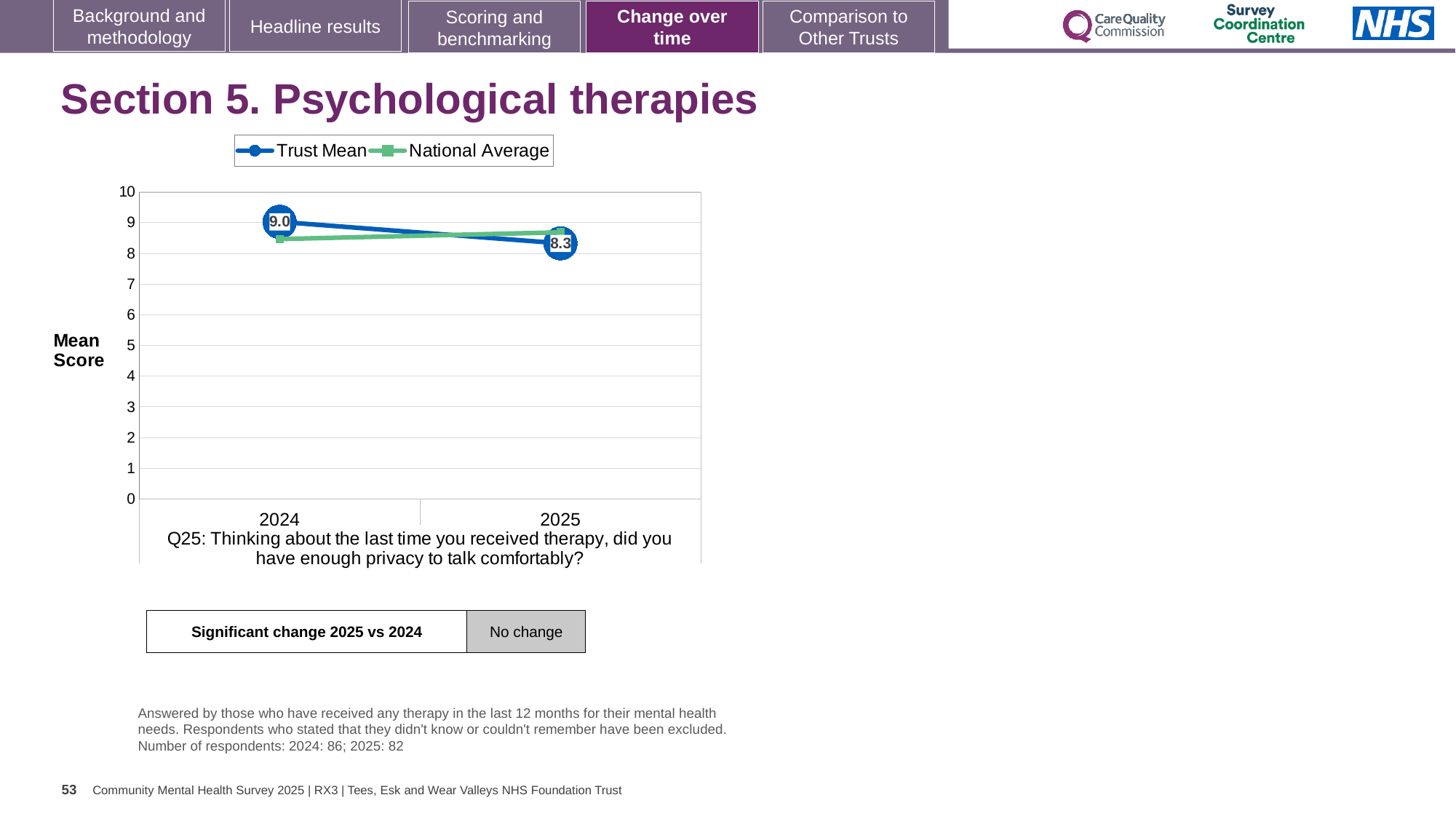
What is the Trust Mean score for 2025? 8.3 By how much did the Trust Mean score change from 2024 to 2025? 0.7 How many series does the legend list? 2 In 2024, which is higher, the Trust Mean or the National Average? Trust Mean Which year has the higher Trust Mean score, 2024 or 2025? 2024 What is the Trust Mean score for 2024? 9.0 What are the two series named in the legend? Trust Mean and National Average Is the National Average value for 2025 greater or less than 9? less How many years are plotted on the x axis? 2 Does the Trust Mean rise or fall from 2024 to 2025? fall What kind of chart is shown on the slide? line chart Is the National Average value for 2024 greater or less than 8? greater